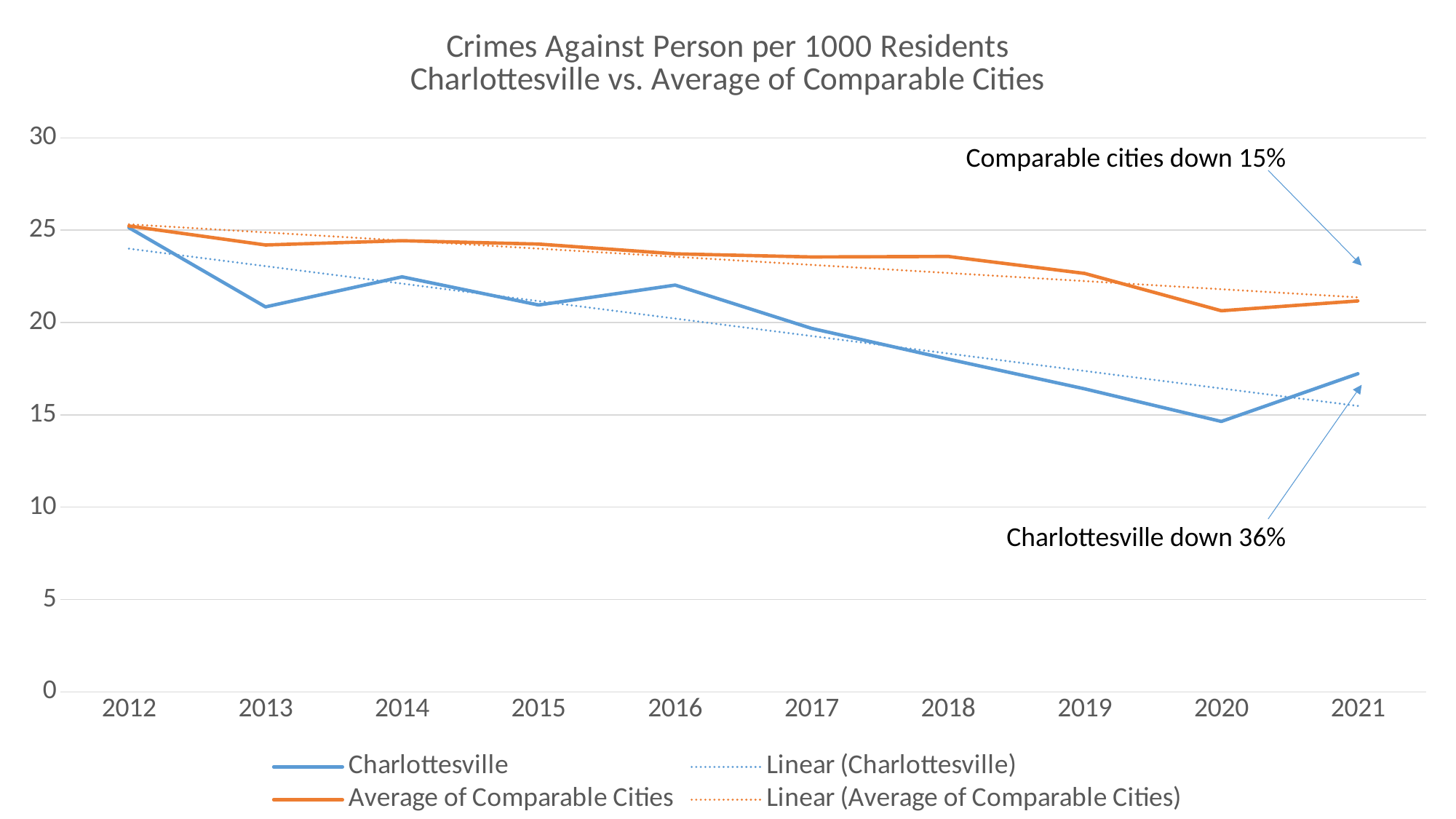
Is the Average of Comparable Cities value for 2018 greater or less than 20? greater How many series does the legend list? 4 Does the Charlottesville line generally rise or fall from 2012 to 2021? fall Is the Charlottesville value for 2020 greater or less than 15? less In 2021, which is higher: Charlottesville or Average of Comparable Cities? Average of Comparable Cities What kind of chart is shown on the slide? line chart Is the Charlottesville value for 2016 greater or less than 20? greater Does the Average of Comparable Cities line generally rise or fall from 2012 to 2021? fall According to the annotation on the chart, by what percentage is Charlottesville down? 36% How many years are plotted along the x axis? 10 In which year is the Charlottesville value lowest? 2020 In which year is the Charlottesville value highest? 2012